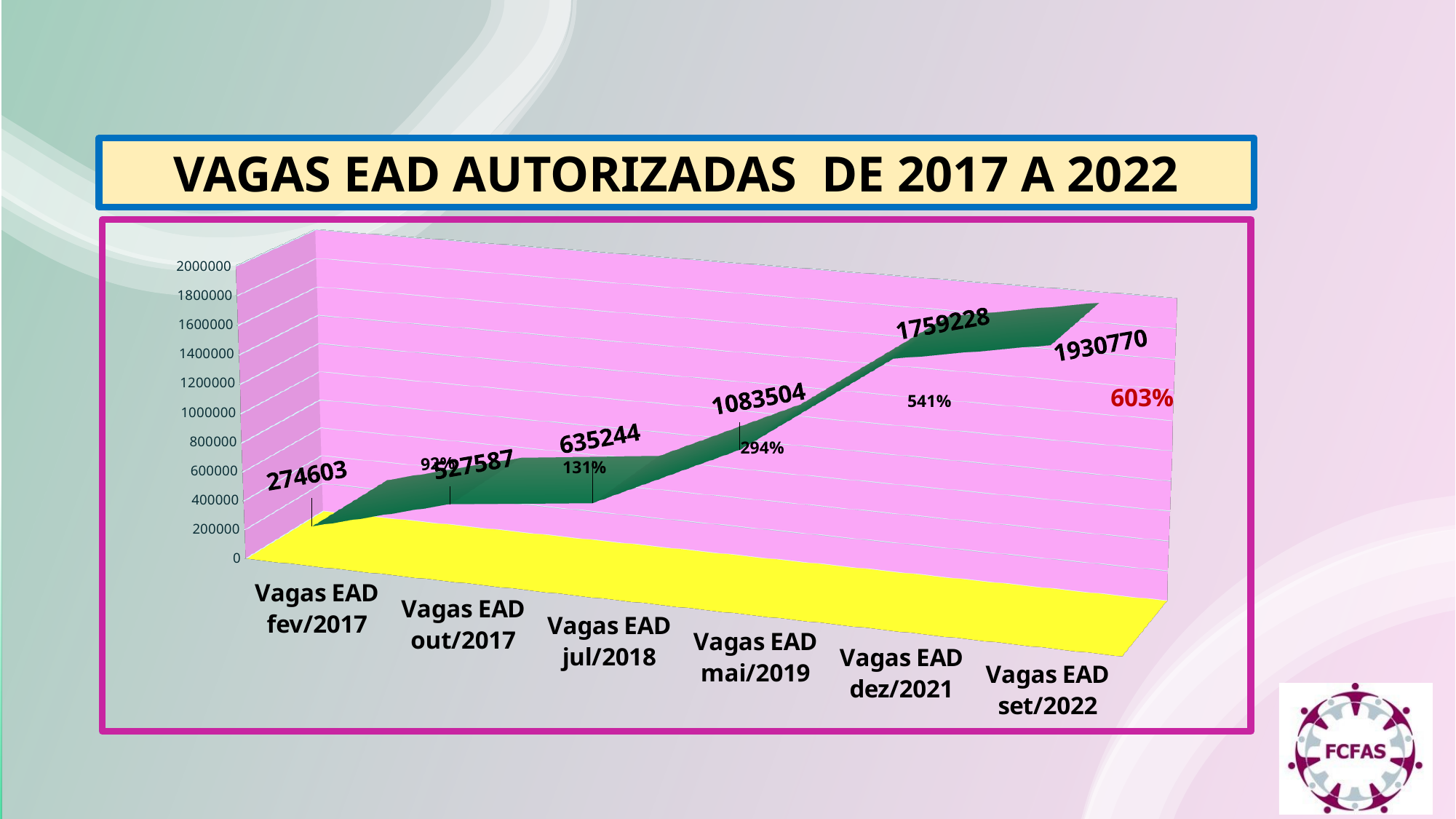
What is the difference between the values for Vagas EAD set/2022 and Vagas EAD fev/2017? 1656167 What is the title of the slide above the chart? VAGAS EAD AUTORIZADAS DE 2017 A 2022 Which category has the lowest value? Vagas EAD fev/2017 What is the value for Vagas EAD set/2022? 1930770 What is the value for Vagas EAD mai/2019? 1083504 What is the value for Vagas EAD fev/2017? 274603 Which is larger, the value for Vagas EAD jul/2018 or Vagas EAD out/2017? Vagas EAD jul/2018 What is the value for Vagas EAD dez/2021? 1759228 How many categories are shown on the x axis? 6 Do the values rise or fall from fev/2017 to set/2022? rise Which category has the highest value? Vagas EAD set/2022 What kind of chart is shown on the slide? 3D line chart